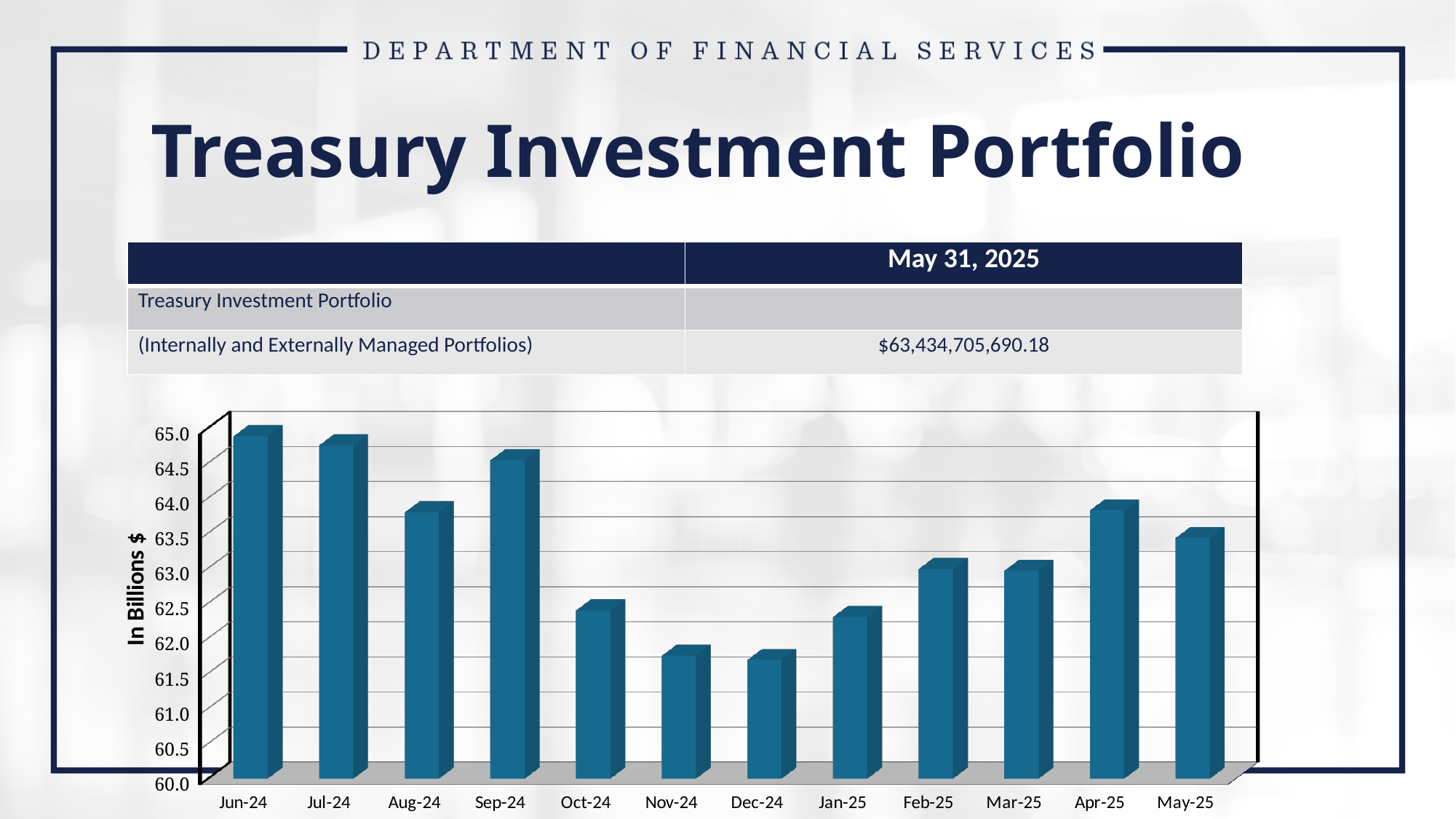
Which is larger, the value for Apr-25 or the value for May-25? Apr-25 Is the value for Jun-24 greater or less than 64.5? greater How many months (bars) are plotted in the chart? 12 Do the values generally rise or fall from Dec-24 to Apr-25? Rise What is the label on the vertical axis of the chart? In Billions $ Is the value for Oct-24 greater or less than 63.0? less Which is larger, the value for Jun-24 or the value for Dec-24? Jun-24 Which month is the first category on the x axis of the chart? Jun-24 What kind of chart is shown on the slide? Bar chart Is the value for Nov-24 greater or less than 62.0? less